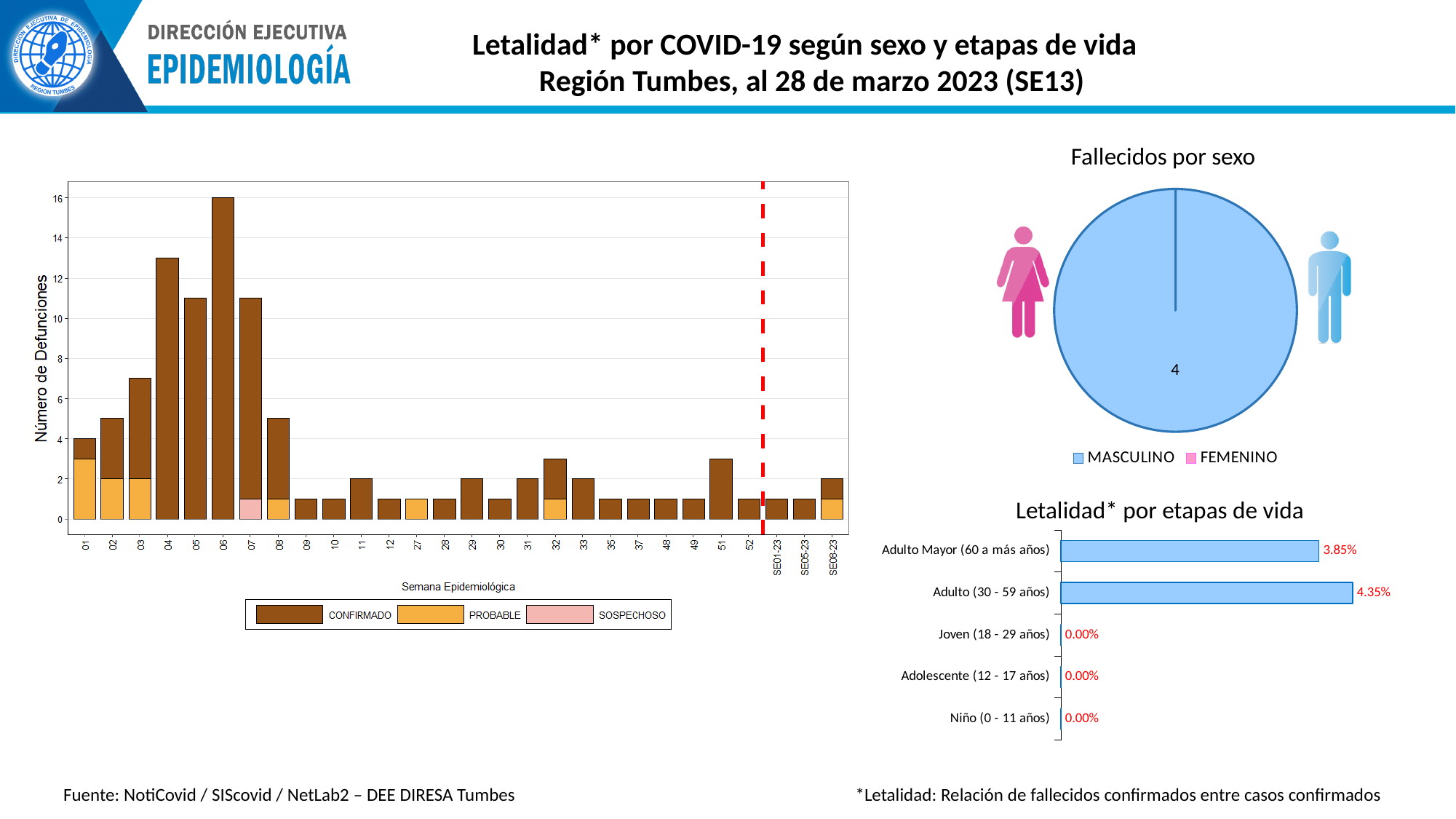
In the chart 'Letalidad* por etapas de vida', how many age groups are shown? 5 In the chart 'Letalidad* por etapas de vida', what is the value for Adulto Mayor (60 a más años)? 3.85% In the bar chart on the left (Número de Defunciones by Semana Epidemiológica), how many series does the legend list? 3 In the chart 'Letalidad* por etapas de vida', what is the value for Adulto (30 - 59 años)? 4.35% In the pie chart 'Fallecidos por sexo', what value is printed on the MASCULINO slice? 4 In the bar chart on the left (Número de Defunciones by Semana Epidemiológica), what is the total number of deaths for week 06? 16 In the chart 'Letalidad* por etapas de vida', what is the difference between the values for Adulto (30 - 59 años) and Adulto Mayor (60 a más años)? 0.50% In the bar chart on the left (Número de Defunciones by Semana Epidemiológica), which week has the highest total number of deaths? 06 In the chart 'Letalidad* por etapas de vida', what is the value for Joven (18 - 29 años)? 0.00% In the bar chart on the left (Número de Defunciones by Semana Epidemiológica), is the total for week 04 greater or less than 12? greater In the pie chart 'Fallecidos por sexo', how many categories does the legend list? 2 In the chart 'Letalidad* por etapas de vida', which age group has the highest value? Adulto (30 - 59 años)